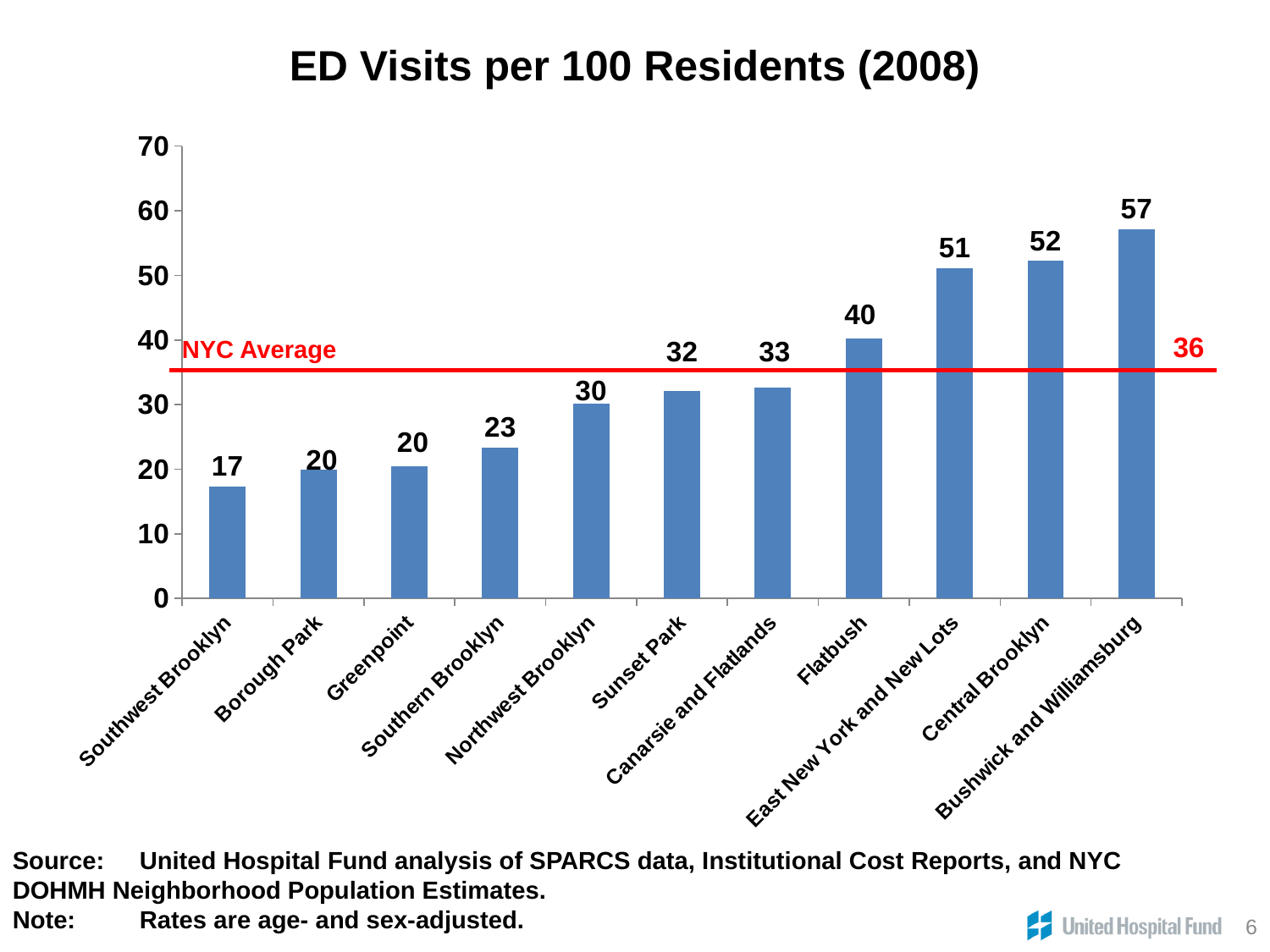
Which neighborhood has the highest ED visits per 100 residents? Bushwick and Williamsburg Is the value for Northwest Brooklyn greater or less than 40? less What kind of chart is shown on the slide? bar chart What is the value for Southwest Brooklyn? 17 How many neighborhoods are shown on the chart? 11 What value is shown for the NYC Average line? 36 Do the values rise or fall from left to right along the x axis? rise Which is larger, the value for Sunset Park or the value for Flatbush? Flatbush What is the value for Central Brooklyn? 52 What is the value for Flatbush? 40 Which neighborhood has the lowest ED visits per 100 residents? Southwest Brooklyn What is the difference between the values for Bushwick and Williamsburg and Southwest Brooklyn? 40